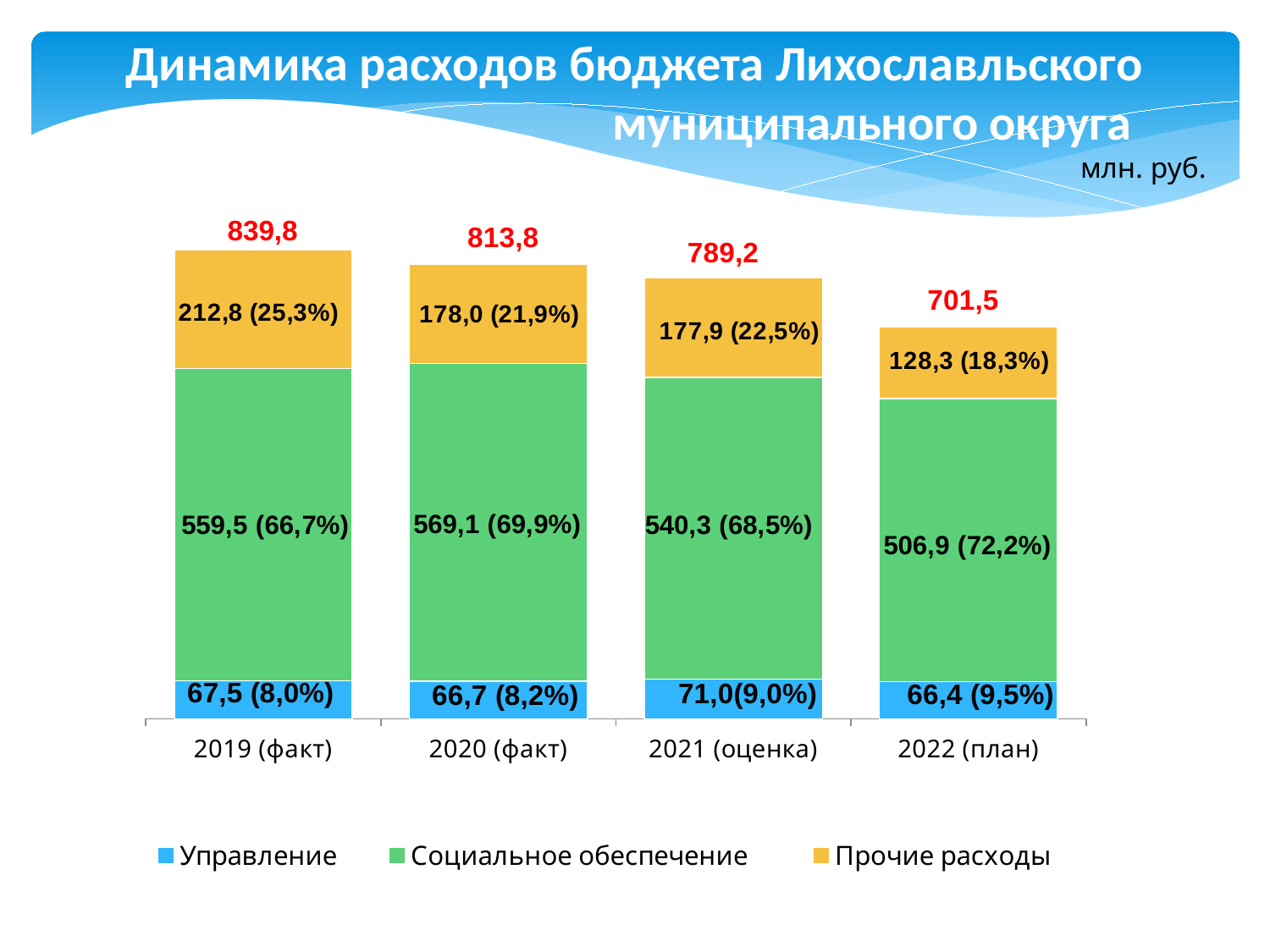
What type of chart is shown on the slide? stacked bar chart What is the value of Управление for 2021 (оценка)? 71,0(9,0%) What is the total value of the bar for 2019 (факт)? 839,8 Do the bar totals rise or fall from 2019 (факт) to 2022 (план)? fall Which category has the lowest total? 2022 (план) What is the value of Прочие расходы for 2020 (факт)? 178,0 (21,9%) How many categories are shown on the x axis? 4 Which category has the highest total? 2019 (факт) What unit is stated for the values on the slide? млн. руб. What is the difference between the Прочие расходы values for 2019 (факт) and 2022 (план)? 84,5 What is the value of Социальное обеспечение for 2022 (план)? 506,9 (72,2%) How many series does the legend list? 3